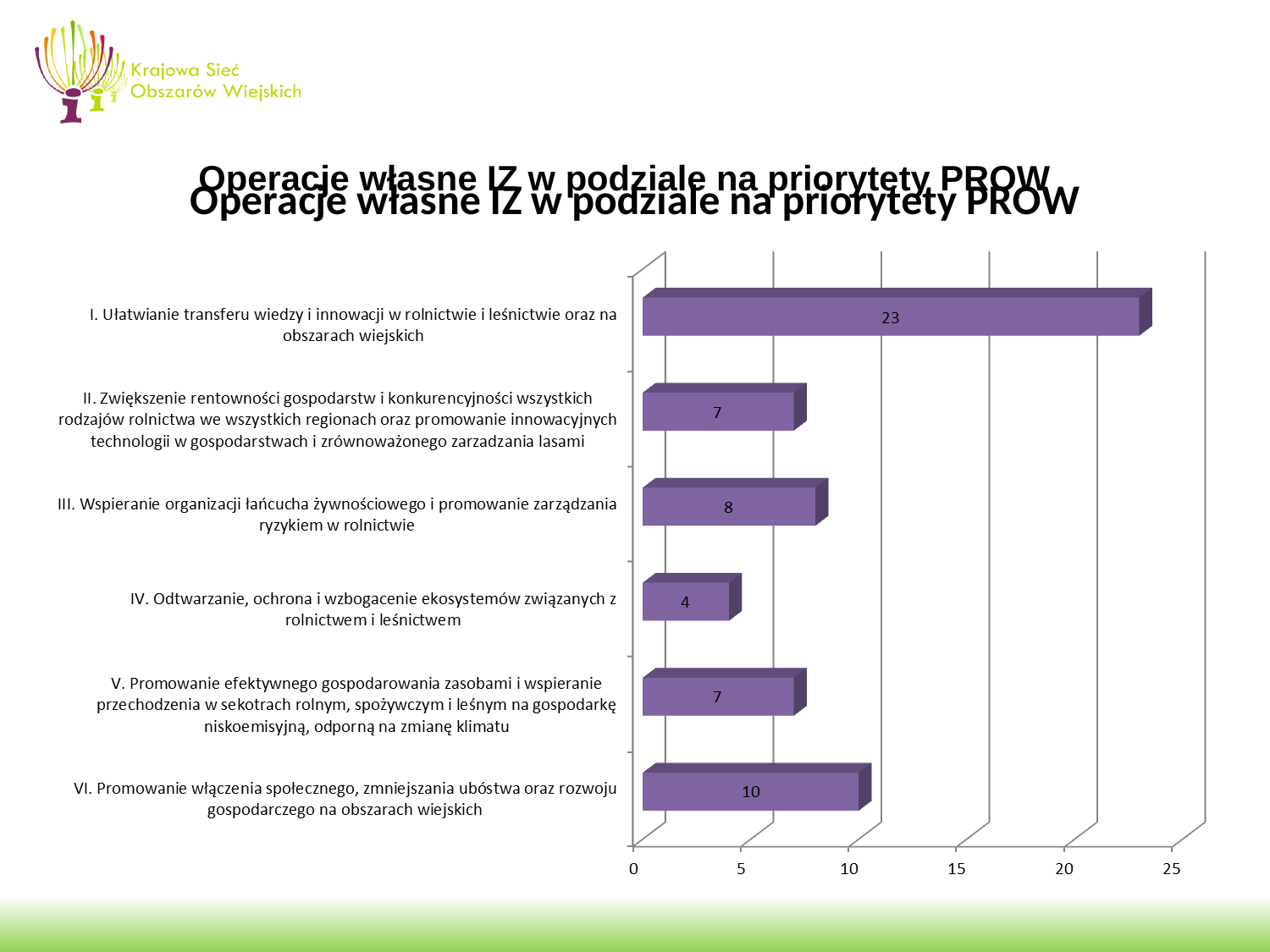
What is the value for priority III (Wspieranie organizacji łańcucha żywnościowego i promowanie zarządzania ryzykiem w rolnictwie)? 8 What is the title of the chart? Operacje własne IZ w podziale na priorytety PROW Which priority has the highest value? I. Ułatwianie transferu wiedzy i innowacji w rolnictwie i leśnictwie oraz na obszarach wiejskich What kind of chart is shown on the slide? Bar chart What is the value for priority I (Ułatwianie transferu wiedzy i innowacji w rolnictwie i leśnictwie oraz na obszarach wiejskich)? 23 What is the value for priority VI (Promowanie włączenia społecznego, zmniejszania ubóstwa oraz rozwoju gospodarczego na obszarach wiejskich)? 10 What is the difference between the value for priority I and the value for priority VI? 13 How many priorities (categories) are shown in the chart? 6 What is the value for priority IV (Odtwarzanie, ochrona i wzbogacenie ekosystemów związanych z rolnictwem i leśnictwem)? 4 Which priority has the lowest value? IV. Odtwarzanie, ochrona i wzbogacenie ekosystemów związanych z rolnictwem i leśnictwem Which is larger, the value for priority III or the value for priority II? Priority III What is the maximum value shown on the horizontal axis? 25